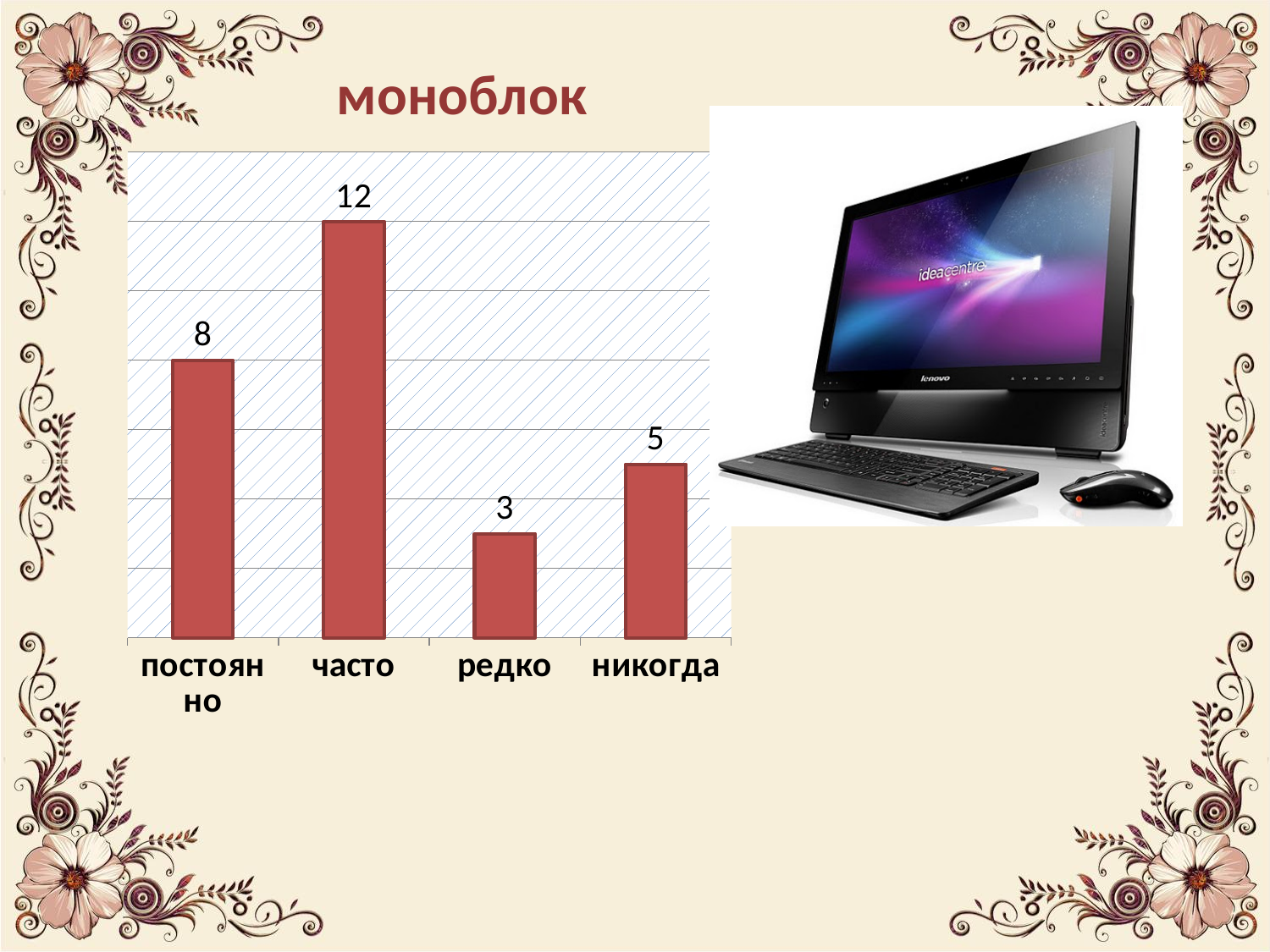
What is the title of the chart? моноблок What is the difference between the values for "никогда" and "редко"? 2 What is the value for "никогда"? 5 What is the value for "часто"? 12 How many categories are shown on the x axis? 4 What is the value for "редко"? 3 What kind of chart is shown on the slide? bar chart Which category has the highest value? часто What is the difference between the values for "часто" and "постоянно"? 4 What is the value for "постоянно"? 8 Which is larger, the value for "постоянно" or the value for "никогда"? постоянно Which category has the lowest value? редко